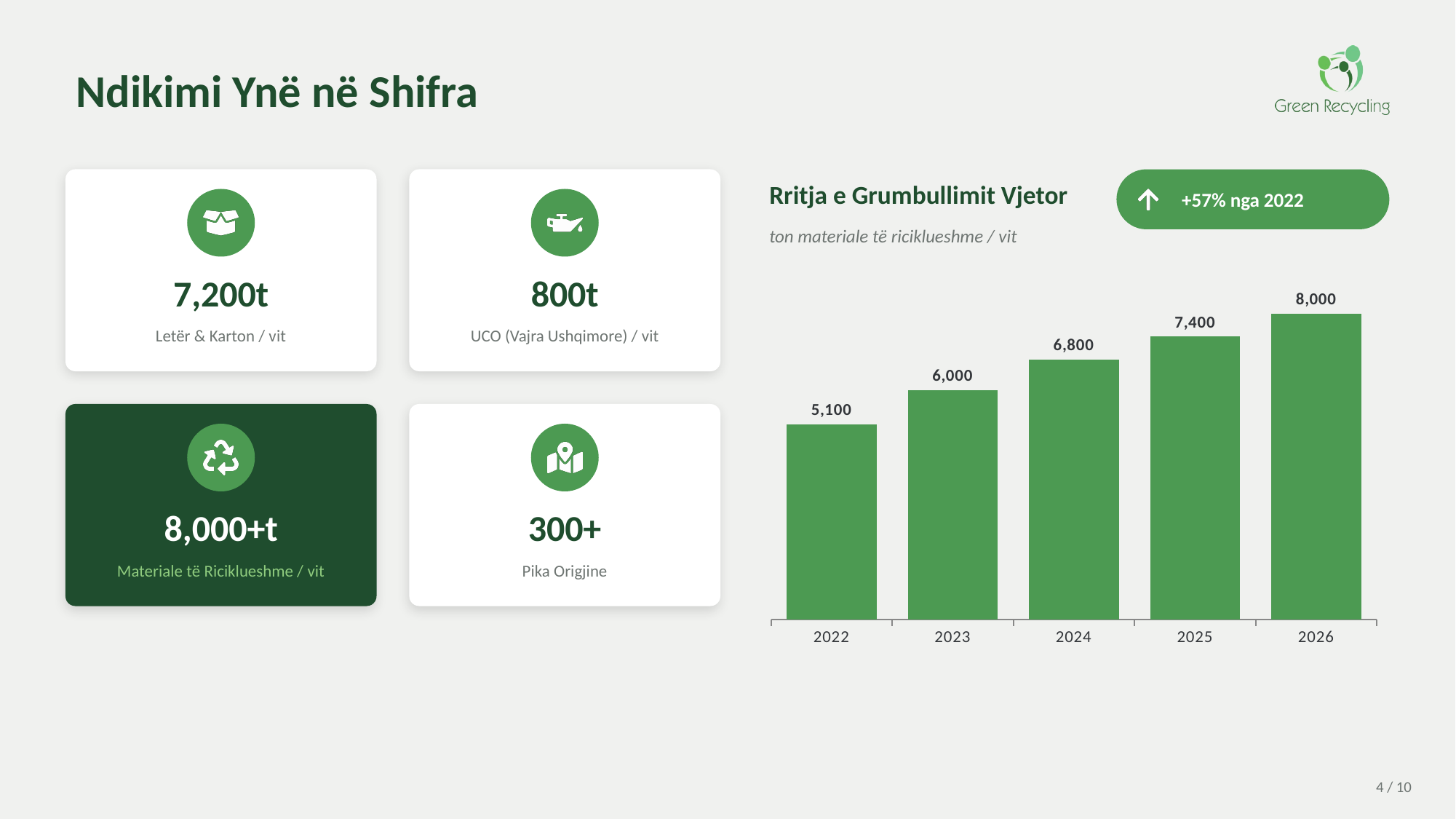
What is the difference between the values for 2026 and 2022? 2,900 What is the difference between the values for 2025 and 2023? 1,400 What is the title of the chart? Rritja e Grumbullimit Vjetor Which year has the highest value in the chart? 2026 What kind of chart is shown on the slide? bar chart Which year has the lowest value in the chart? 2022 What is the value for 2026 in the chart? 8,000 What is the value for 2024 in the chart? 6,800 Do the values rise or fall from 2022 to 2026? rise What is the value for 2022 in the chart? 5,100 Which is larger, the value for 2023 or the value for 2024? 2024 How many years are shown in the chart? 5